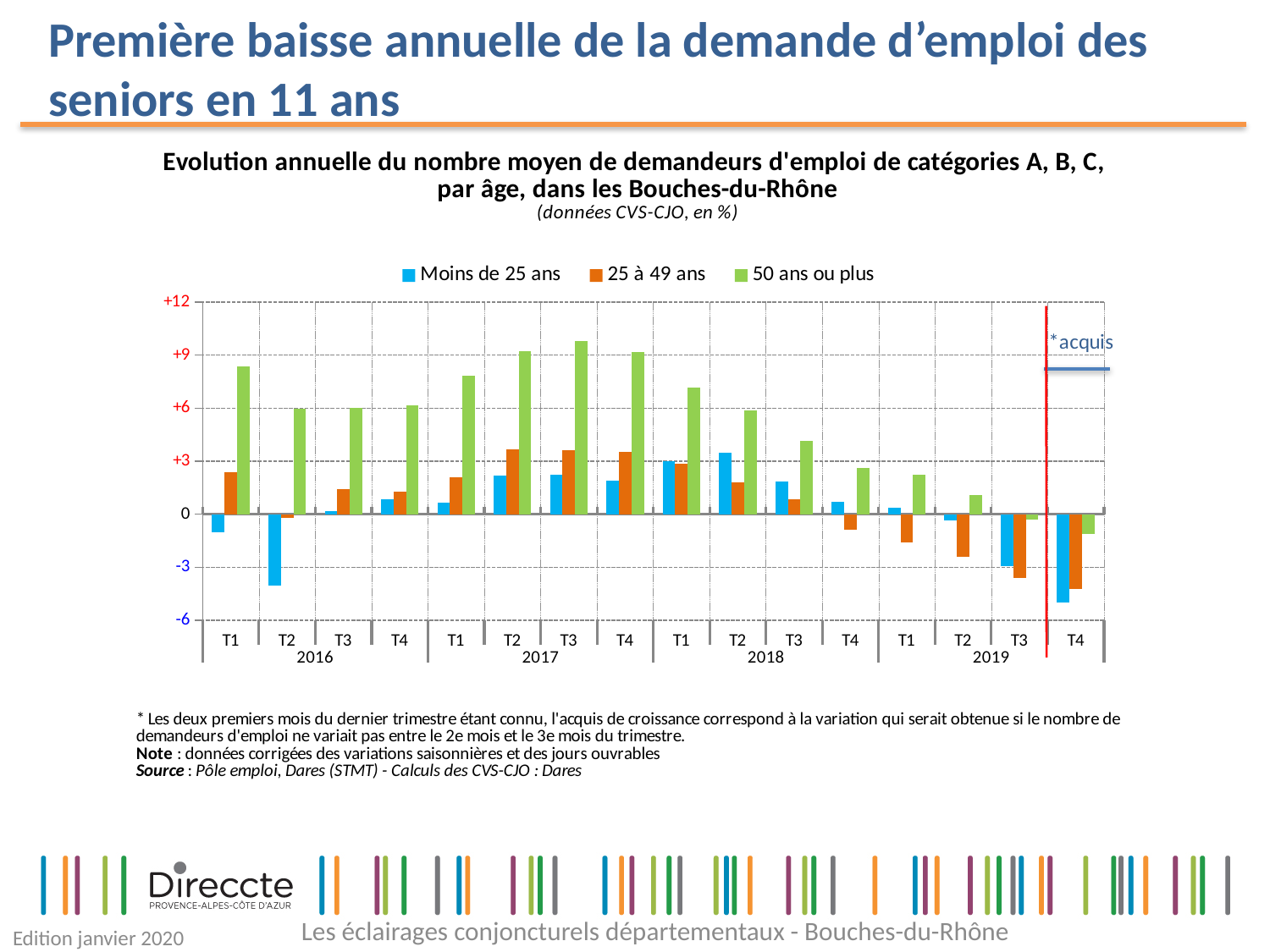
Is the value for '25 à 49 ans' in T4 2019 greater or less than -3? less Is the value for '50 ans ou plus' in T1 2016 greater or less than +6? greater What colour represents the '50 ans ou plus' series? green What kind of chart is shown on the slide? bar chart In which quarter does the 'Moins de 25 ans' series reach its lowest value? T4 2019 In T1 2016, which is larger: the value for '50 ans ou plus' or for '25 à 49 ans'? 50 ans ou plus Is the value for 'Moins de 25 ans' in T2 2016 greater or less than -3? less Do the values for '50 ans ou plus' rise or fall from T3 2017 to T4 2019? fall How many series does the legend list? 3 In which quarter does the '50 ans ou plus' series reach its highest value? T3 2017 Which quarter is marked as 'acquis' on the chart? T4 2019 How many quarters are plotted along the x axis? 16